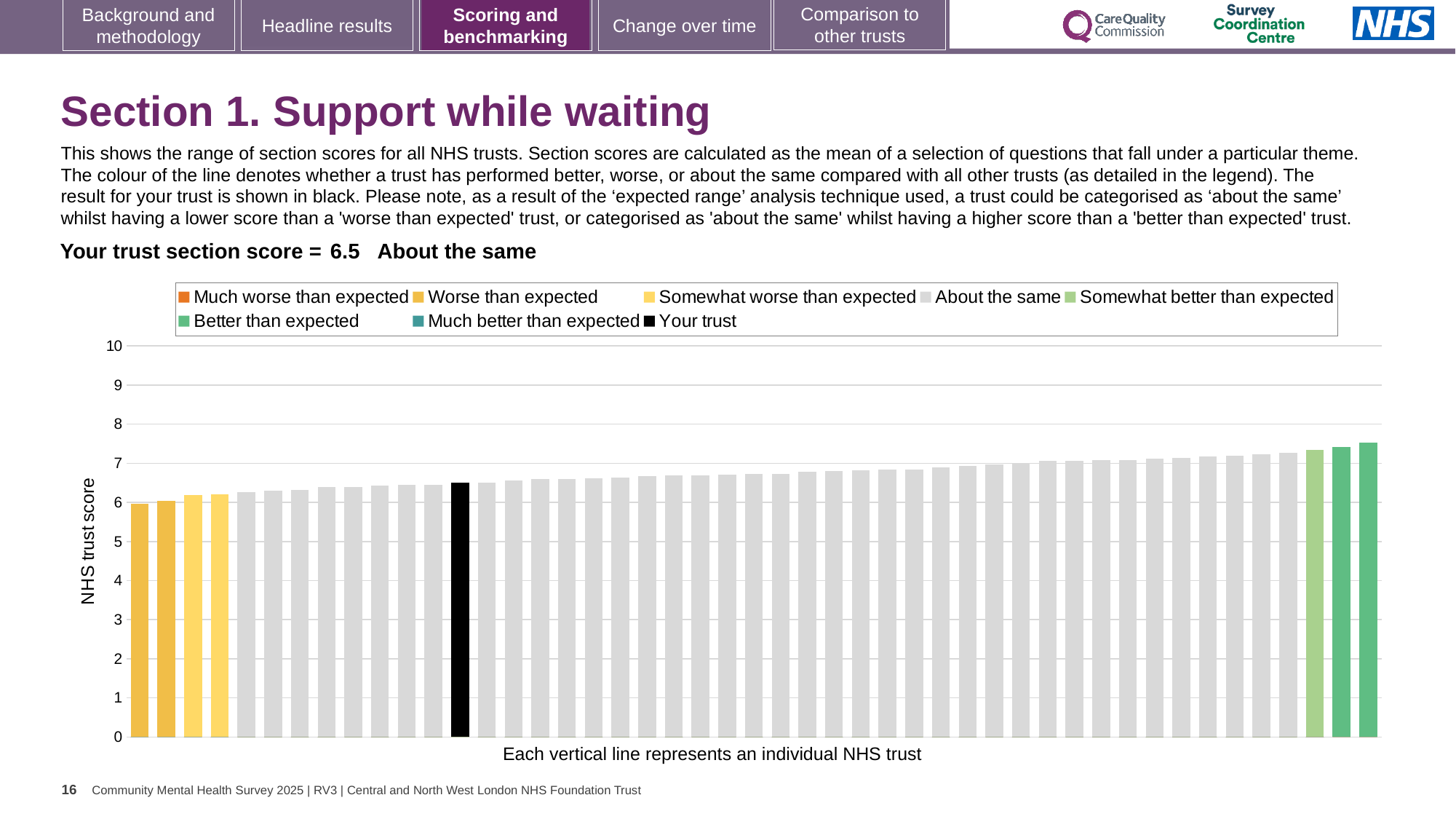
What is the title of the vertical axis of the chart? NHS trust score What is the section score for your trust shown on the slide? 6.5 What kind of chart is shown on the slide? Bar chart Is the value of the rightmost bar greater or less than 7? greater How many entries does the chart legend list? 8 How many bars are coloured as 'Better than expected'? 2 How many bars are coloured as 'Worse than expected'? 2 Do the bar values rise or fall from left to right across the chart? Rise Is the value of the leftmost bar greater or less than 7? less Is the value of the black bar (your trust) greater or less than 7? less Which performance category is your trust placed in for this section? About the same How many bars are coloured as 'Somewhat better than expected'? 1